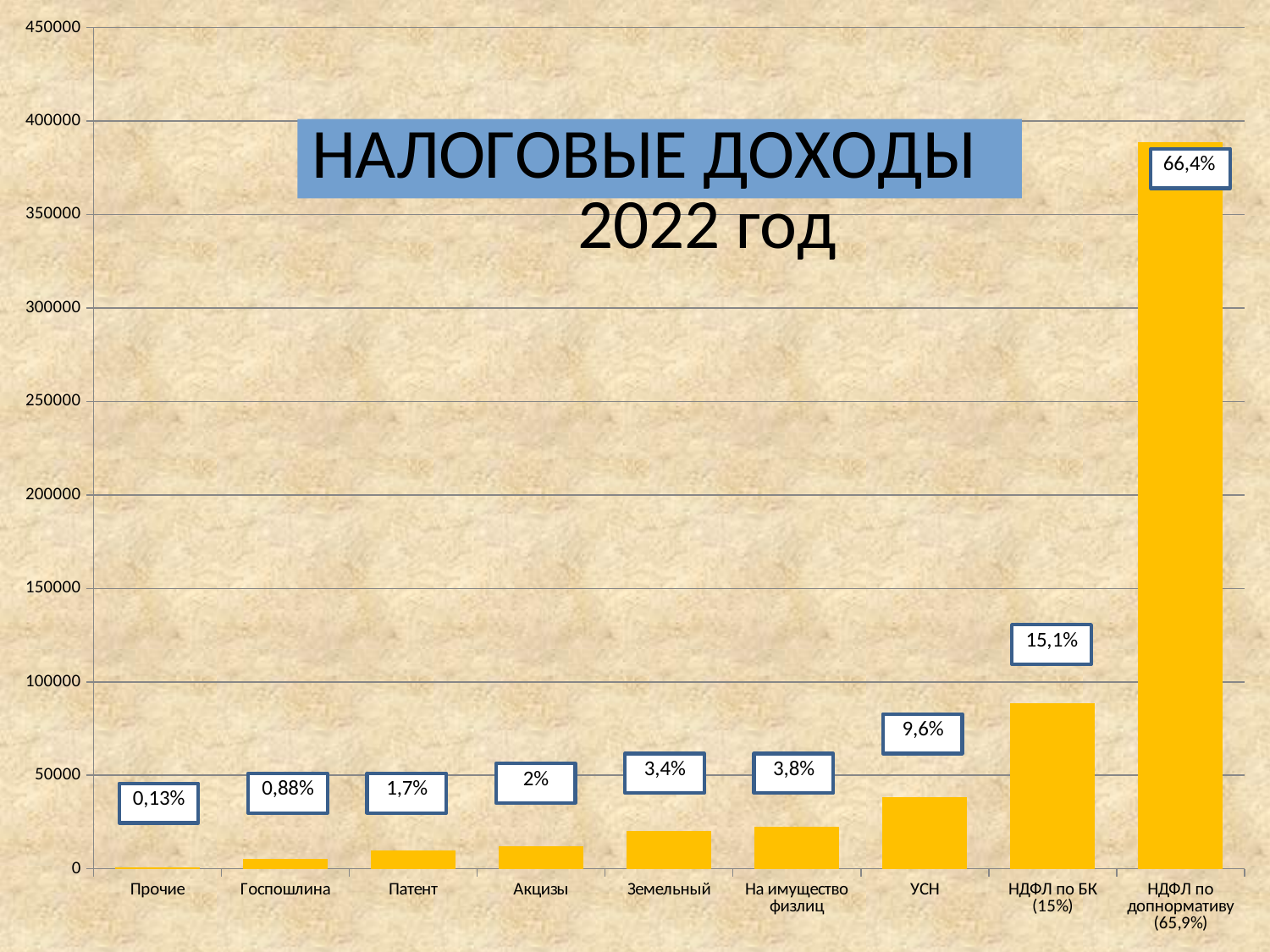
Which category has the lowest bar? Прочие What kind of chart is shown on the slide? bar chart How many categories are shown on the x axis? 9 What percentage label is shown for НДФЛ по БК (15%)? 15,1% Which category has the highest bar? НДФЛ по допнормативу (65,9%) Is the value for НДФЛ по допнормативу (65,9%) greater or less than 350000? greater What percentage label is shown for Земельный? 3,4% What percentage label is shown for Прочие? 0,13% Is the value for НДФЛ по БК (15%) greater or less than 100000? less What percentage label is shown for УСН? 9,6% What is the title of the chart? НАЛОГОВЫЕ ДОХОДЫ 2022 год Which bar is taller, УСН or Акцизы? УСН